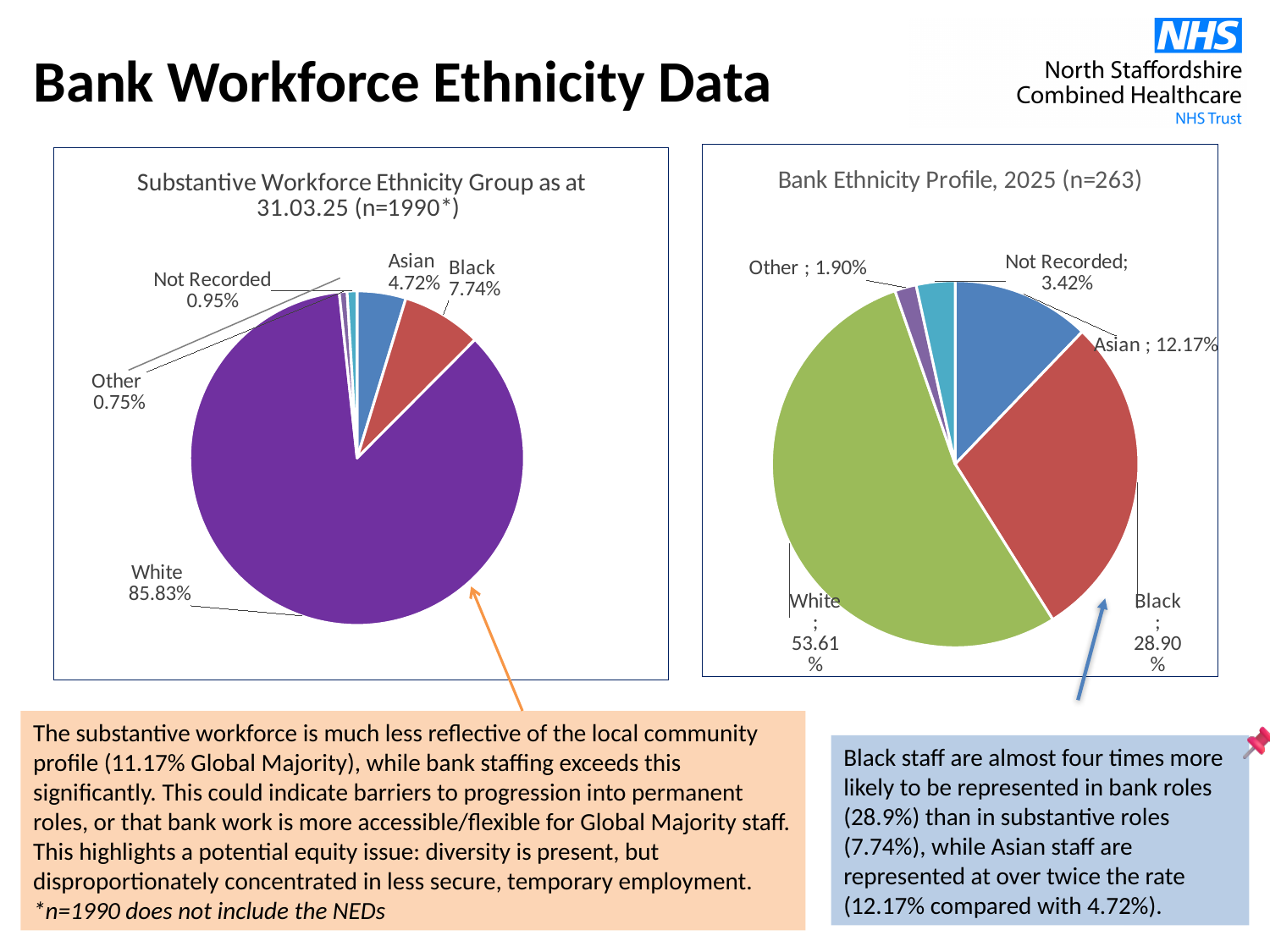
In the Bank Ethnicity Profile, 2025 pie chart, what share is labelled for Not Recorded? 3.42% In the Bank Ethnicity Profile, 2025 pie chart, what is the difference between the White share and the Black share? 24.71% In the Substantive Workforce Ethnicity Group pie chart, which category has the smallest slice? Other What is the sample size (n) given in the title of the Bank Ethnicity Profile chart? 263 In the Bank Ethnicity Profile, 2025 pie chart, which category has the largest slice? White In the Bank Ethnicity Profile, 2025 pie chart, which category has the smallest slice? Other In the Substantive Workforce Ethnicity Group pie chart, what share is labelled for Black? 7.74% In the Bank Ethnicity Profile, 2025 pie chart, what share is labelled for Asian? 12.17% In the Substantive Workforce Ethnicity Group pie chart, which is larger, the Asian share or the Black share? Black What type of chart is the Substantive Workforce Ethnicity Group chart? Pie chart How many categories are shown in the Bank Ethnicity Profile, 2025 pie chart? 5 In the Substantive Workforce Ethnicity Group pie chart, what share is labelled for White? 85.83%